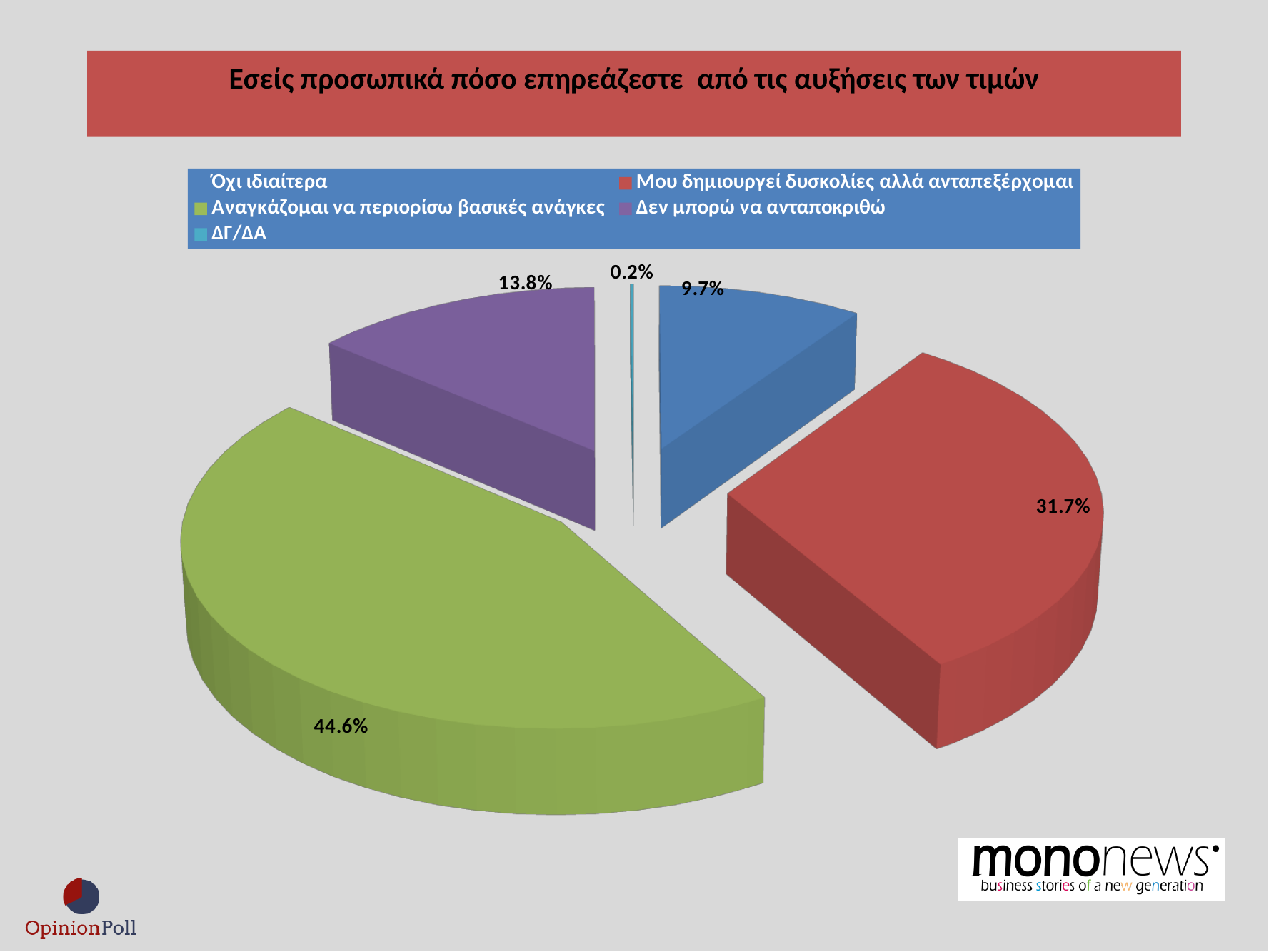
What colour is the slice for "Μου δημιουργεί δυσκολίες αλλά ανταπεξέρχομαι"? red What kind of chart is shown on the slide? pie chart What percentage of respondents answered "Όχι ιδιαίτερα"? 9.7% What is the difference in percentage points between "Αναγκάζομαι να περιορίσω βασικές ανάγκες" and "Μου δημιουργεί δυσκολίες αλλά ανταπεξέρχομαι"? 12.9 Which is larger: the share for "Δεν μπορώ να ανταποκριθώ" or the share for "Όχι ιδιαίτερα"? Δεν μπορώ να ανταποκριθώ Which response has the smallest share of the pie? ΔΓ/ΔΑ What percentage of respondents answered "ΔΓ/ΔΑ"? 0.2% What percentage of respondents answered "Δεν μπορώ να ανταποκριθώ"? 13.8% How many slices does the pie chart have? 5 What percentage of respondents answered "Αναγκάζομαι να περιορίσω βασικές ανάγκες"? 44.6% Which response has the largest share of the pie? Αναγκάζομαι να περιορίσω βασικές ανάγκες What percentage of respondents answered "Μου δημιουργεί δυσκολίες αλλά ανταπεξέρχομαι"? 31.7%